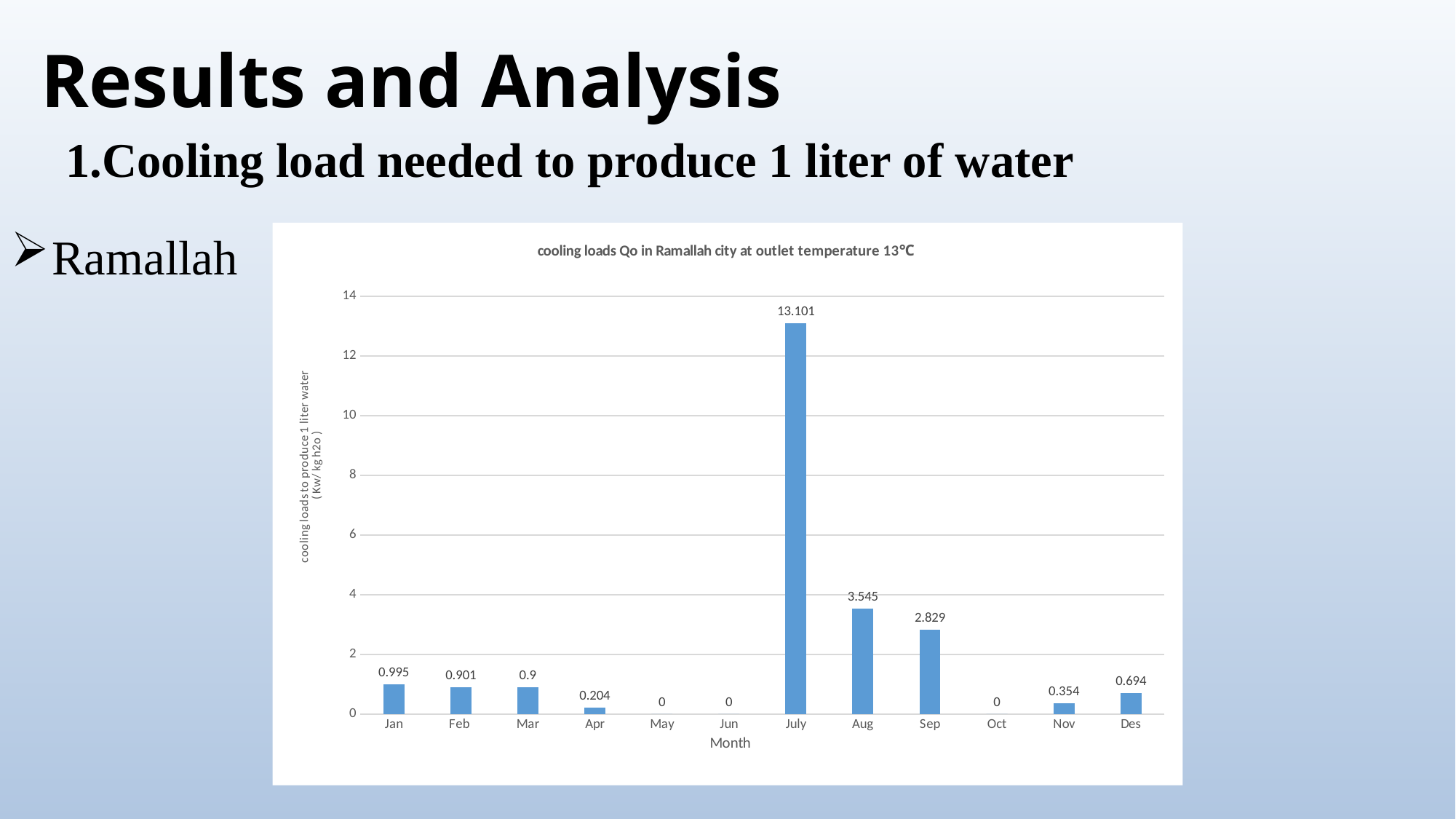
How many months have a cooling load value of 0? 3 What is the cooling load value for July? 13.101 What kind of chart is shown on the slide? bar chart How many months are shown on the x axis? 12 What is the title of the chart? cooling loads Qo in Ramallah city at outlet temperature 13℃ What is the cooling load value for Apr? 0.204 What is the difference between the cooling load values for Aug and Sep? 0.716 What is the label of the x axis? Month Is the value for July greater or less than 12? greater What is the cooling load value for Aug? 3.545 Which has a larger cooling load value, Jan or Des? Jan Which month has the highest cooling load? July